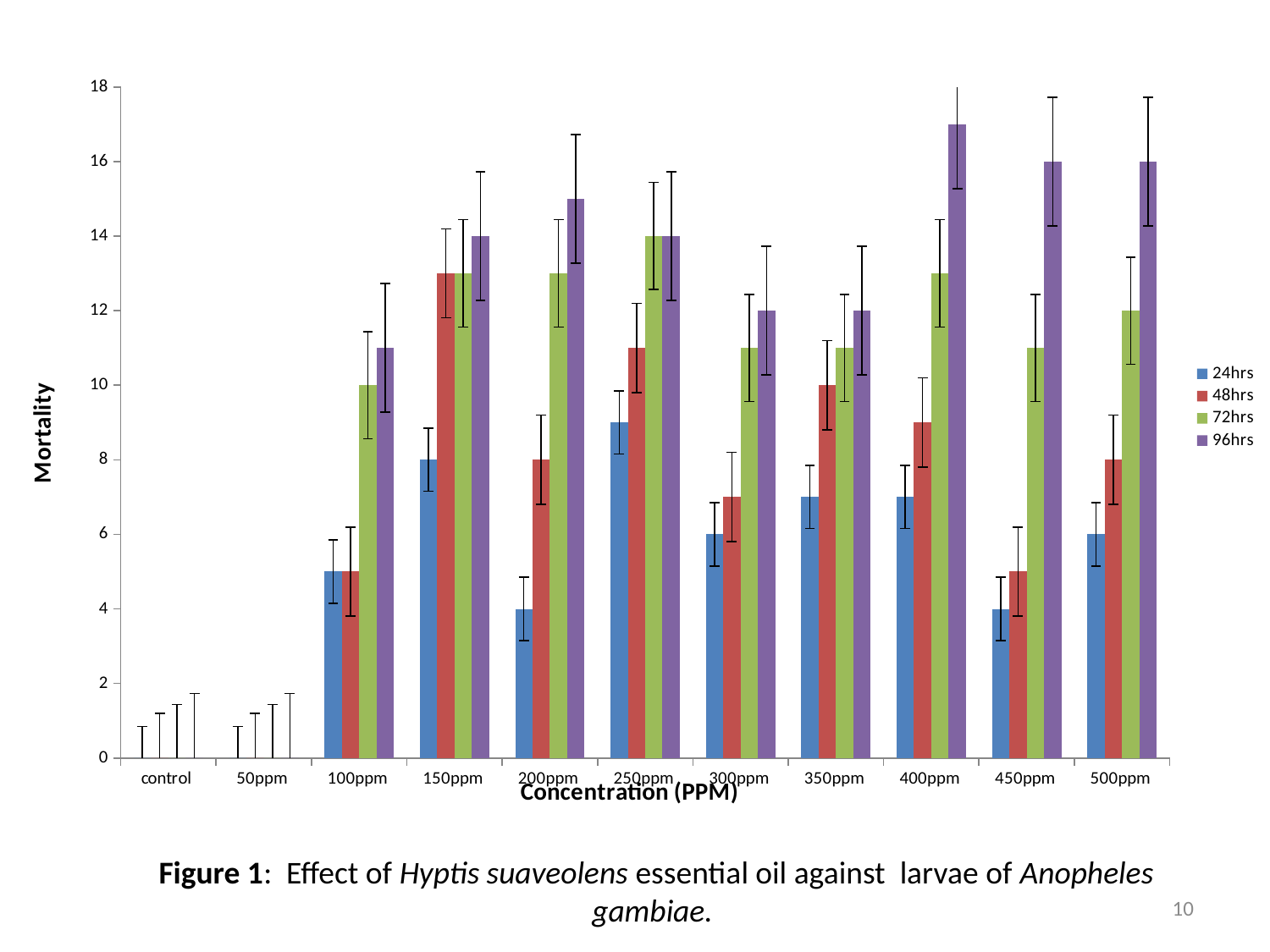
What is the 96hrs mortality value at 450ppm? 16 What type of chart is shown on the slide? bar chart At which concentration is the 96hrs mortality highest? 400ppm How many concentration categories are shown on the x axis? 11 What is the 72hrs mortality value at 100ppm? 10 What is the 24hrs mortality value at 150ppm? 8 Which series is shown in purple in the legend? 96hrs Which is larger, the 96hrs value at 100ppm or the 96hrs value at 200ppm? 96hrs at 200ppm What is the label of the y axis? Mortality How many series does the legend list? 4 Is the 48hrs value at 150ppm greater or less than 12? greater What is the difference between the 96hrs value and the 24hrs value at 450ppm? 12